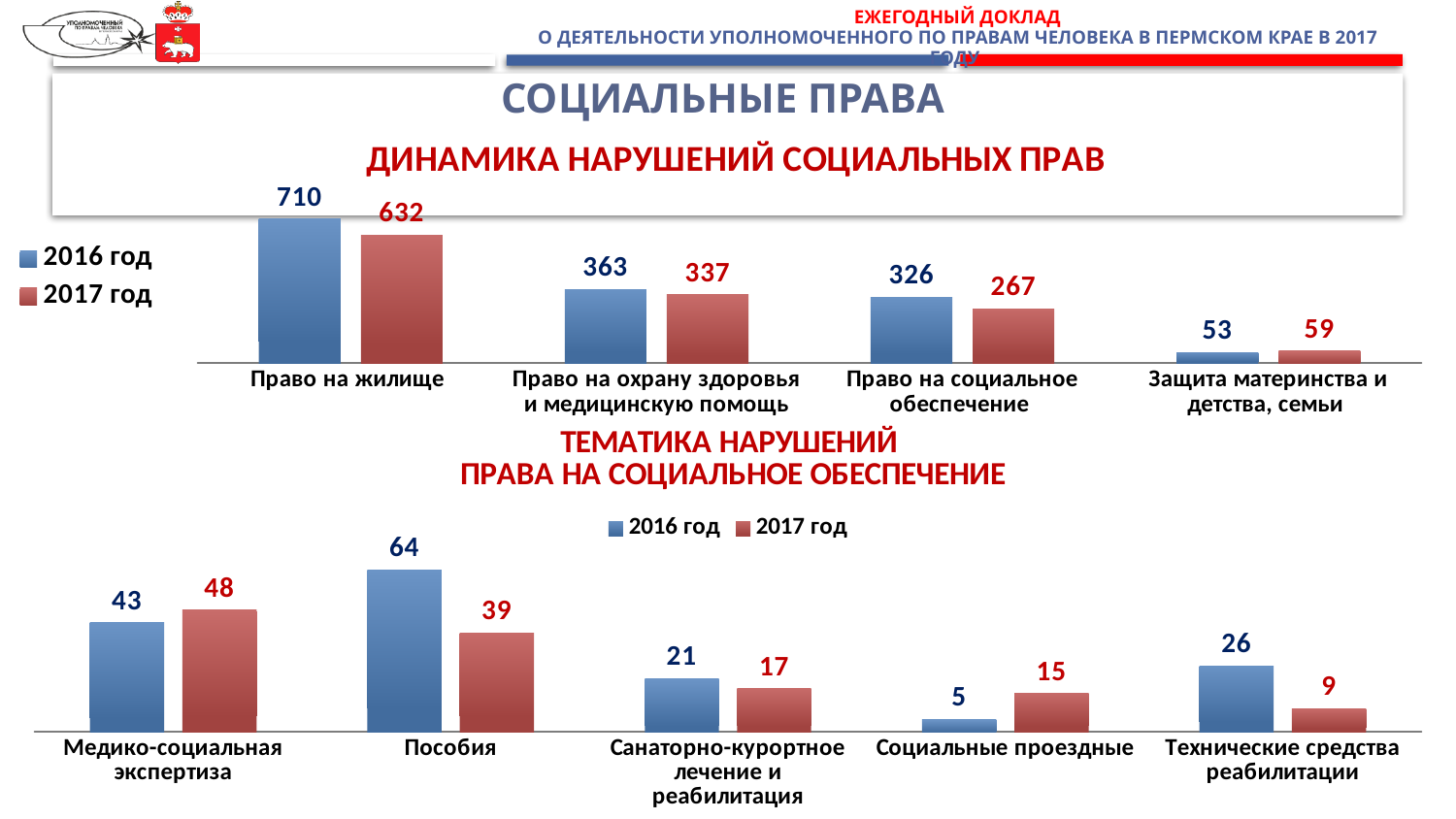
In the bottom chart 'ТЕМАТИКА НАРУШЕНИЙ ПРАВА НА СОЦИАЛЬНОЕ ОБЕСПЕЧЕНИЕ', what is the value for 'Пособия' in 2017 год? 39 In the top chart 'ДИНАМИКА НАРУШЕНИЙ СОЦИАЛЬНЫХ ПРАВ', which is larger for 'Защита материнства и детства, семьи': the 2016 год value or the 2017 год value? 2017 год In the top chart 'ДИНАМИКА НАРУШЕНИЙ СОЦИАЛЬНЫХ ПРАВ', what is the value for 'Право на жилище' in 2016 год? 710 In the bottom chart 'ТЕМАТИКА НАРУШЕНИЙ ПРАВА НА СОЦИАЛЬНОЕ ОБЕСПЕЧЕНИЕ', what is the difference between the 2017 год and 2016 год values for 'Социальные проездные'? 10 How many series does the legend of the bottom chart 'ТЕМАТИКА НАРУШЕНИЙ ПРАВА НА СОЦИАЛЬНОЕ ОБЕСПЕЧЕНИЕ' list? 2 In the bottom chart 'ТЕМАТИКА НАРУШЕНИЙ ПРАВА НА СОЦИАЛЬНОЕ ОБЕСПЕЧЕНИЕ', which colour represents 2017 год? Red In the top chart 'ДИНАМИКА НАРУШЕНИЙ СОЦИАЛЬНЫХ ПРАВ', which category has the lowest value for 2016 год? Защита материнства и детства, семьи In the top chart 'ДИНАМИКА НАРУШЕНИЙ СОЦИАЛЬНЫХ ПРАВ', what is the difference between the 2016 год and 2017 год values for 'Право на жилище'? 78 What type of chart is the bottom chart 'ТЕМАТИКА НАРУШЕНИЙ ПРАВА НА СОЦИАЛЬНОЕ ОБЕСПЕЧЕНИЕ'? Bar chart How many categories are shown in the top chart 'ДИНАМИКА НАРУШЕНИЙ СОЦИАЛЬНЫХ ПРАВ'? 4 In the top chart 'ДИНАМИКА НАРУШЕНИЙ СОЦИАЛЬНЫХ ПРАВ', what is the value for 'Право на социальное обеспечение' in 2017 год? 267 In the bottom chart 'ТЕМАТИКА НАРУШЕНИЙ ПРАВА НА СОЦИАЛЬНОЕ ОБЕСПЕЧЕНИЕ', which category has the highest value for 2016 год? Пособия